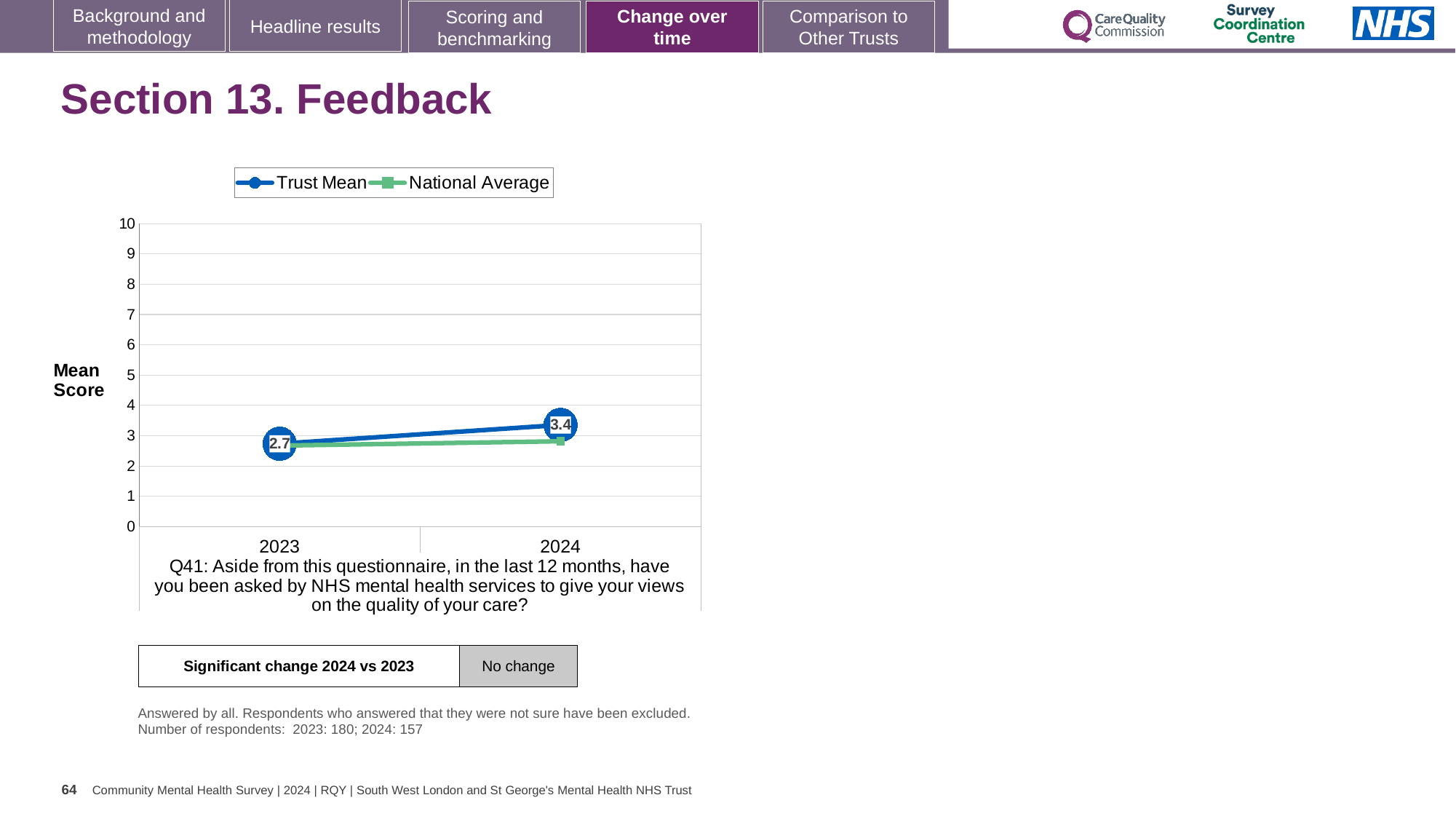
In which year is the Trust Mean higher? 2024 How many years are plotted on the x axis? 2 Does the Trust Mean rise or fall from 2023 to 2024? rise What is the label on the y axis of the chart? Mean Score In 2024, which is larger: the Trust Mean or the National Average? Trust Mean What is the Trust Mean value for 2023? 2.7 What kind of chart is shown on the slide? line chart How many series does the legend list? 2 Is the National Average value for 2024 greater or less than 5? less By how much did the Trust Mean change from 2023 to 2024? 0.7 What does the table below the chart say about the significant change 2024 vs 2023? No change What is the Trust Mean value for 2024? 3.4